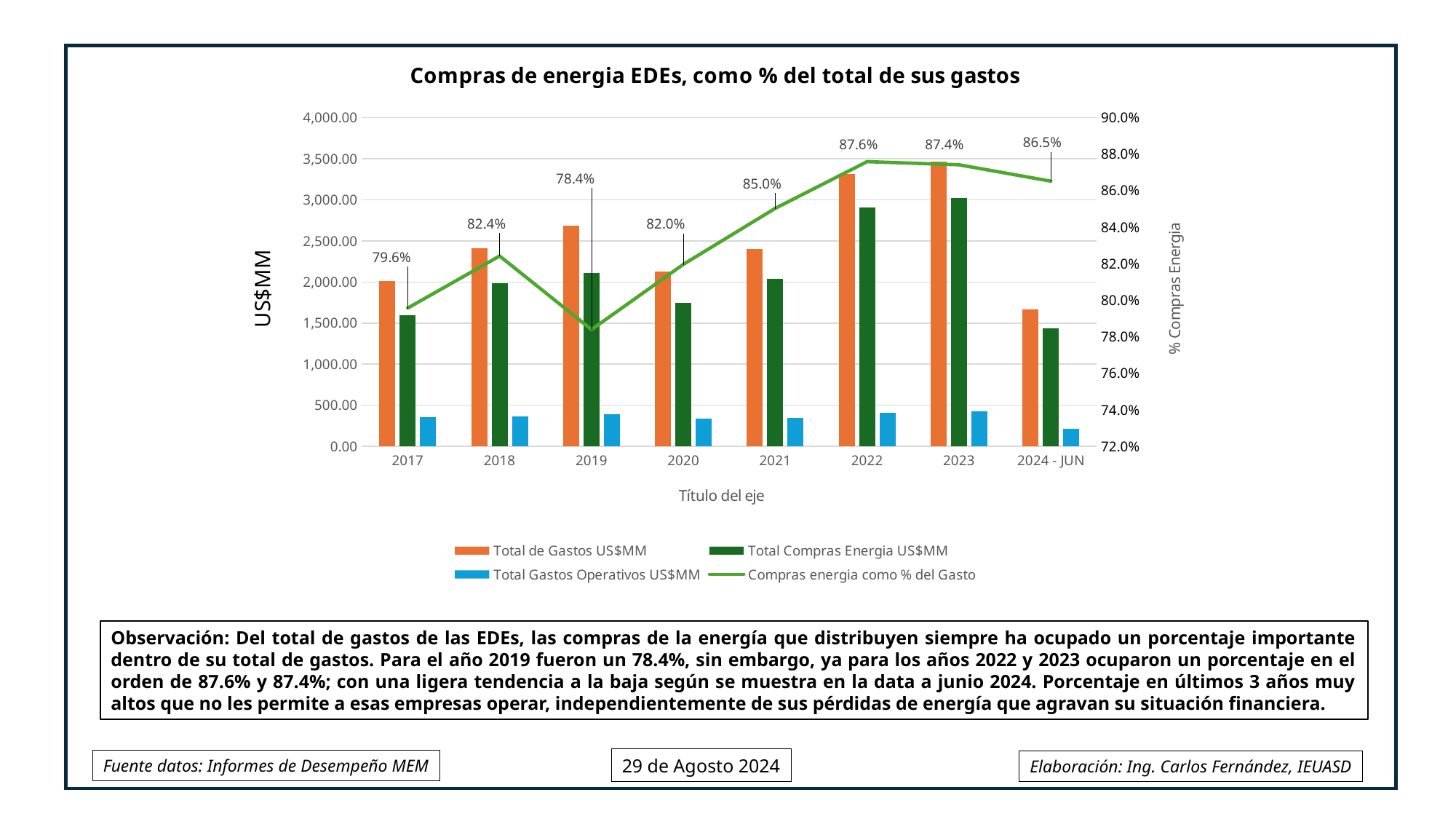
Which year has a higher 'Compras energia como % del Gasto': 2018 or 2020? 2018 What is the value of 'Compras energia como % del Gasto' for 2019? 78.4% What is the value of 'Compras energia como % del Gasto' for 2022? 87.6% How many series does the legend list? 4 In which year is 'Compras energia como % del Gasto' highest? 2022 What is the title of the chart? Compras de energia EDEs, como % del total de sus gastos In which year is 'Compras energia como % del Gasto' lowest? 2019 What is the value of 'Compras energia como % del Gasto' for 2024 - JUN? 86.5% Is the 'Total Gastos Operativos US$MM' bar for 2017 greater or less than 500.00? less Is the 'Total de Gastos US$MM' bar for 2022 greater or less than 3,000.00? greater How many year categories are shown on the x axis? 8 What is the difference in 'Compras energia como % del Gasto' between 2022 and 2019? 9.2%